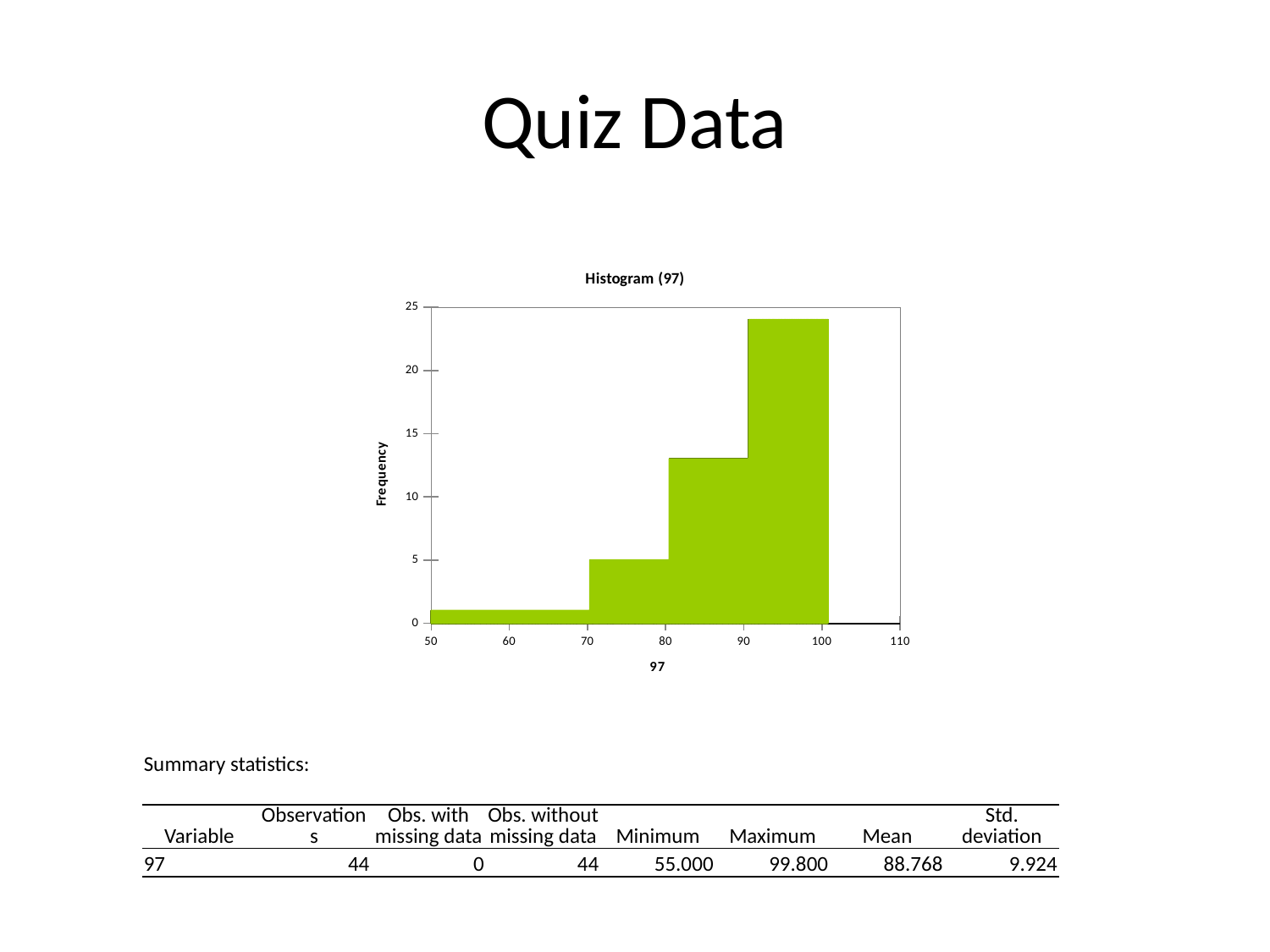
What is the frequency for the 70 to 80 bin? 5 Which bin has a higher frequency, 80 to 90 or 90 to 100? 90 to 100 Is the frequency for the 80 to 90 bin greater or less than 10? greater Is the frequency for the 90 to 100 bin greater or less than 20? greater Which bin has the highest frequency in the histogram? 90 to 100 How many bars are plotted in the histogram? 4 What is the title of the chart? Histogram (97) What kind of chart is shown on the slide? Bar chart (histogram) Which bin has the lowest frequency in the histogram? 50 to 70 What is the label of the vertical axis of the chart? Frequency Do the frequencies rise or fall as the values on the x axis increase from 50 to 100? rise Is the frequency for the 50 to 70 bin greater or less than 5? less